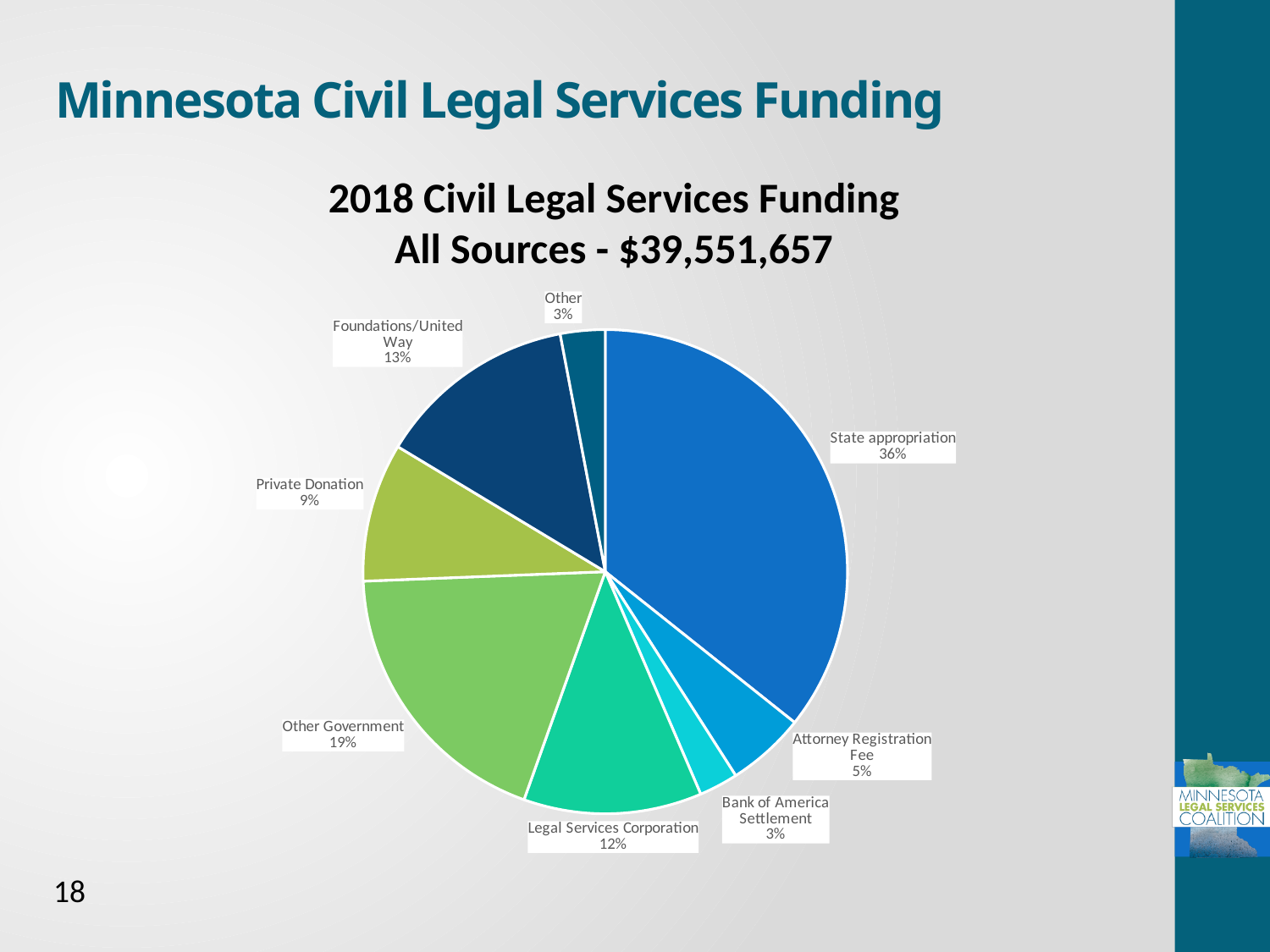
What kind of chart is shown on the slide? Pie chart What is the combined share of Bank of America Settlement and Other? 6% What share of funding comes from Legal Services Corporation? 12% What percentage of funding is labelled Other Government? 19% What share of 2018 Civil Legal Services Funding comes from State appropriation? 36% Which funding source has the largest share of the pie? State appropriation What share of funding comes from the Attorney Registration Fee? 5% What is the difference in percentage points between Other Government and Private Donation? 10 How many slices does the pie chart have? 8 What total funding amount is stated in the chart title? $39,551,657 Which is larger, the share for Foundations/United Way or the share for Legal Services Corporation? Foundations/United Way What percentage of funding comes from Foundations/United Way? 13%